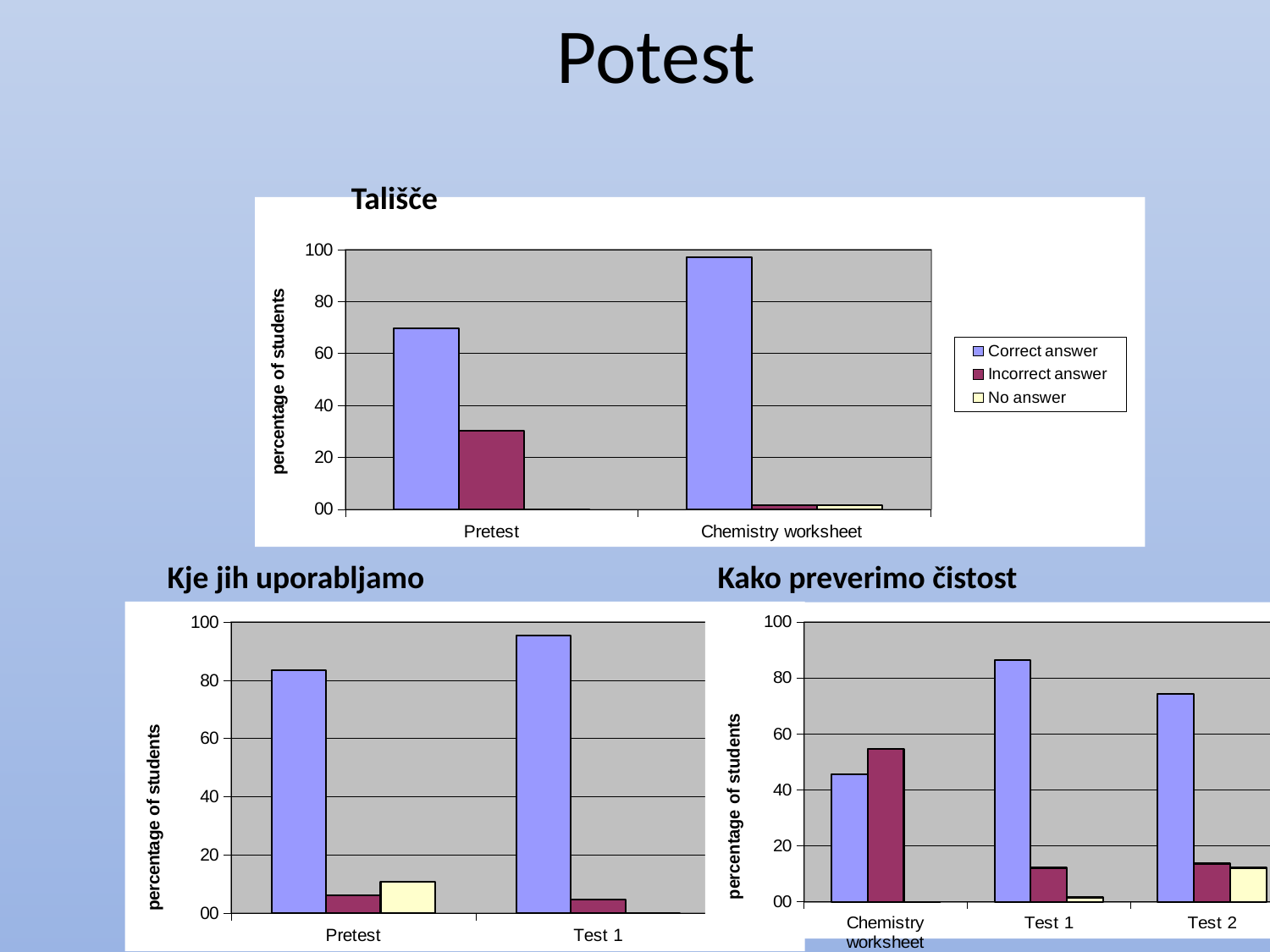
In the 'Kako preverimo čistost' chart, for Chemistry worksheet, which is larger: Correct answer or Incorrect answer? Incorrect answer What is the y-axis label of the 'Kje jih uporabljamo' chart? percentage of students In the 'Kako preverimo čistost' chart, is the Correct answer value for Chemistry worksheet greater or less than 60? less In the 'Tališče' chart, how many categories are shown on the x axis? 2 In the 'Kje jih uporabljamo' chart, is the Correct answer value for Test 1 greater or less than 80? greater In the 'Tališče' chart, is the Correct answer value for Pretest greater or less than 60? greater What kind of chart is the 'Tališče' chart? bar chart In the 'Kako preverimo čistost' chart, which category has the highest Correct answer value? Test 1 In the 'Tališče' chart, which category has the larger Correct answer value, Pretest or Chemistry worksheet? Chemistry worksheet In the 'Tališče' chart, how many series does the legend list? 3 In the 'Kje jih uporabljamo' chart, does the Correct answer value rise or fall from Pretest to Test 1? rise In the 'Kako preverimo čistost' chart, how many categories are shown on the x axis? 3